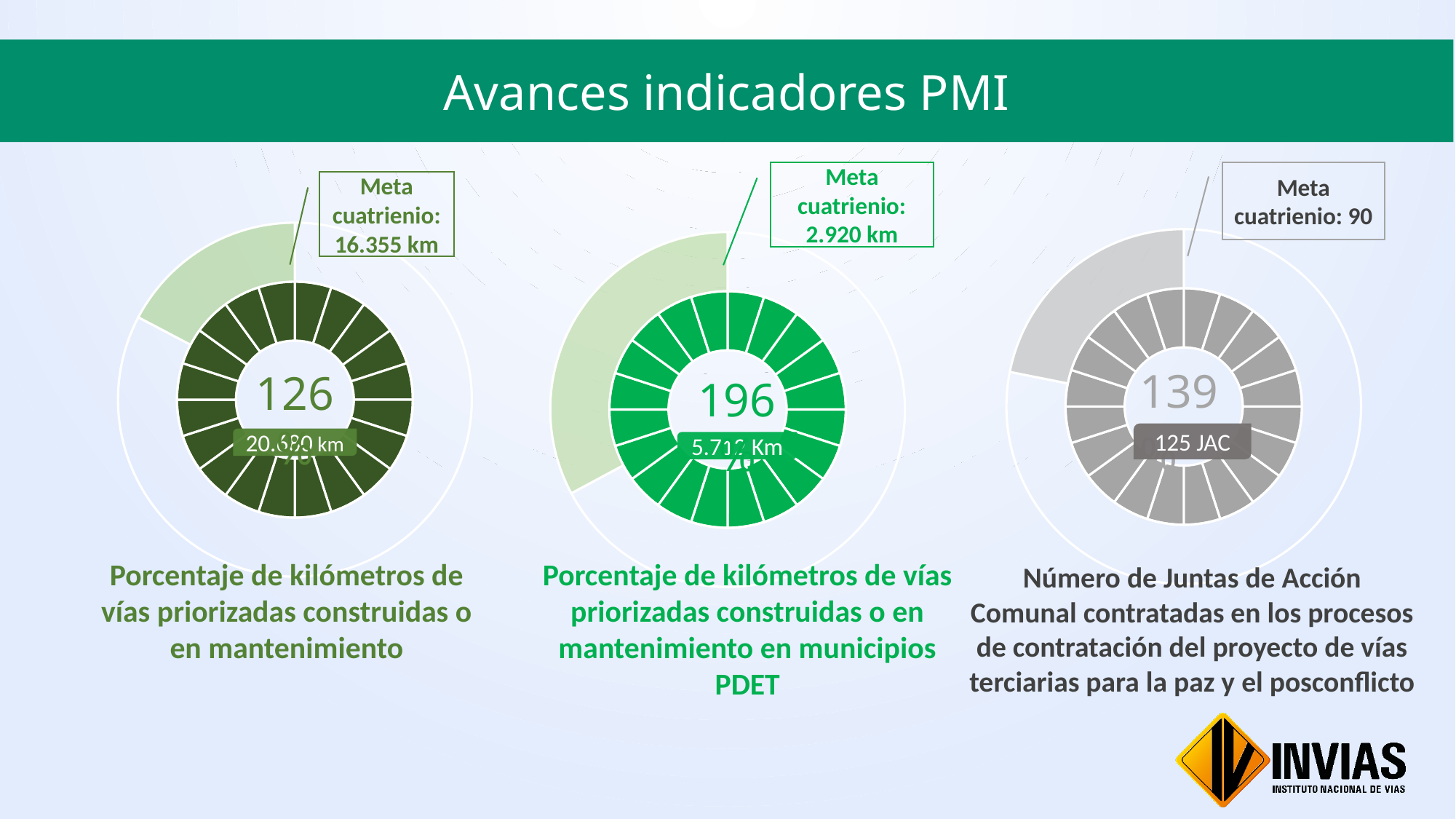
How many gauge charts are shown on the slide? 3 What is the central value shown on the right chart, 'Número de Juntas de Acción Comunal contratadas'? 139 What is the difference between the central value of the middle chart (196) and the left chart (126)? 70 What is the 'Meta cuatrienio' shown for the middle chart (municipios PDET)? 2.920 km What is the central value shown on the middle chart, 'Porcentaje de kilómetros de vías priorizadas construidas o en mantenimiento en municipios PDET'? 196 What is the central value shown on the left chart, 'Porcentaje de kilómetros de vías priorizadas construidas o en mantenimiento'? 126 What kind of chart is used for each indicator on the slide? Donut (gauge) chart What is the 'Meta cuatrienio' shown for the left chart? 16.355 km Which of the three charts shows the highest central value? The middle chart (municipios PDET), 196 What is the 'Meta cuatrienio' shown for the right chart (Juntas de Acción Comunal)? 90 Which of the three charts shows the lowest central value? The left chart, 126 What value is shown in the label inside the right chart below the number 139? 125 JAC